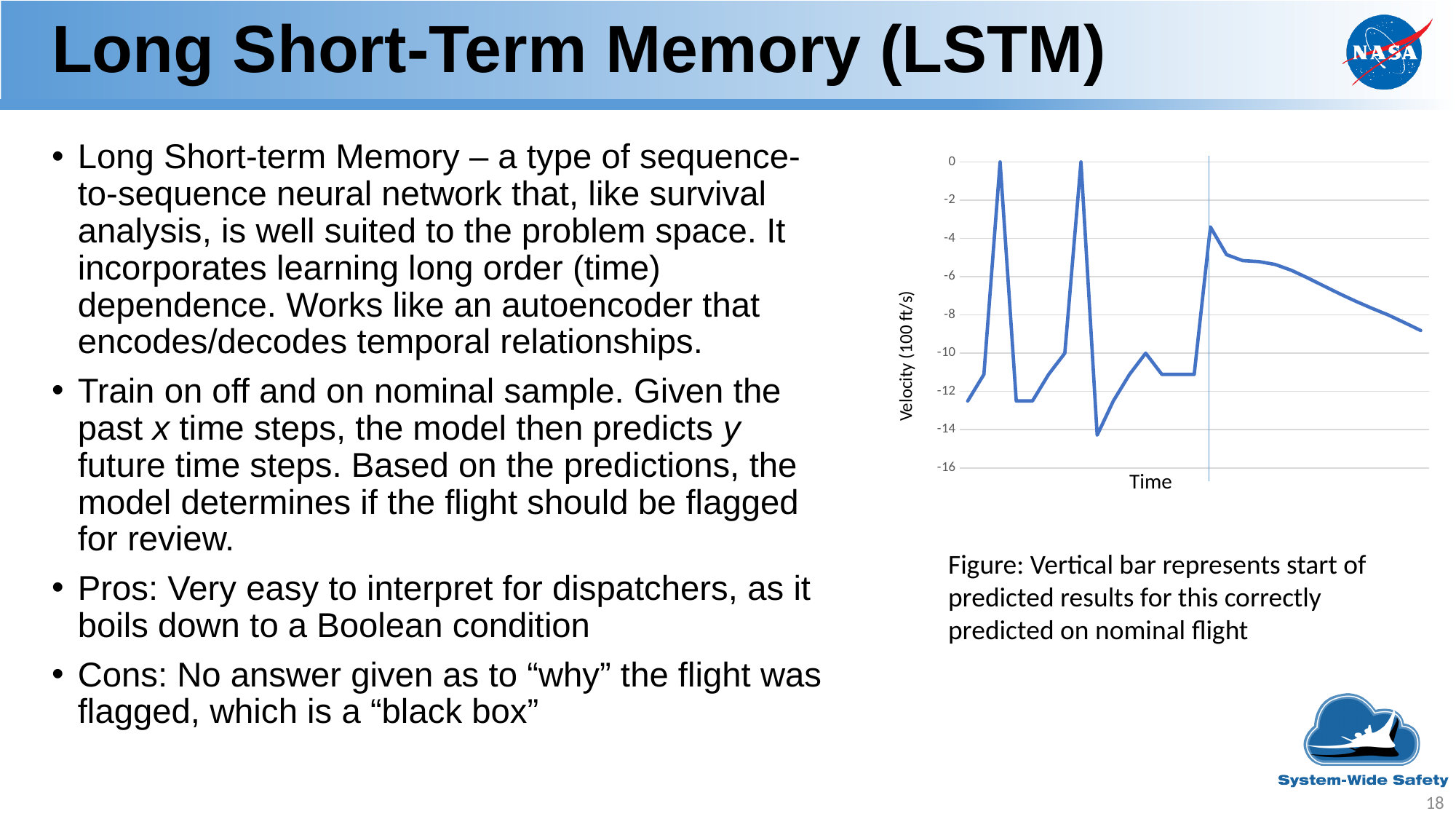
Is the first point of the line (at the left end) greater or less than -10? less How many times does the line spike up to 0 before the vertical bar? 2 What kind of chart is shown on the slide? line chart Is the last point of the line (at the right end) greater or less than -10? greater What is the highest value reached by the line in the chart? 0 Is the value of the line at the vertical bar greater or less than -6? greater What is the label of the vertical axis of the chart? Velocity (100 ft/s) What is the label of the horizontal axis of the chart? Time After the vertical bar, does the line rise or fall as time increases? fall